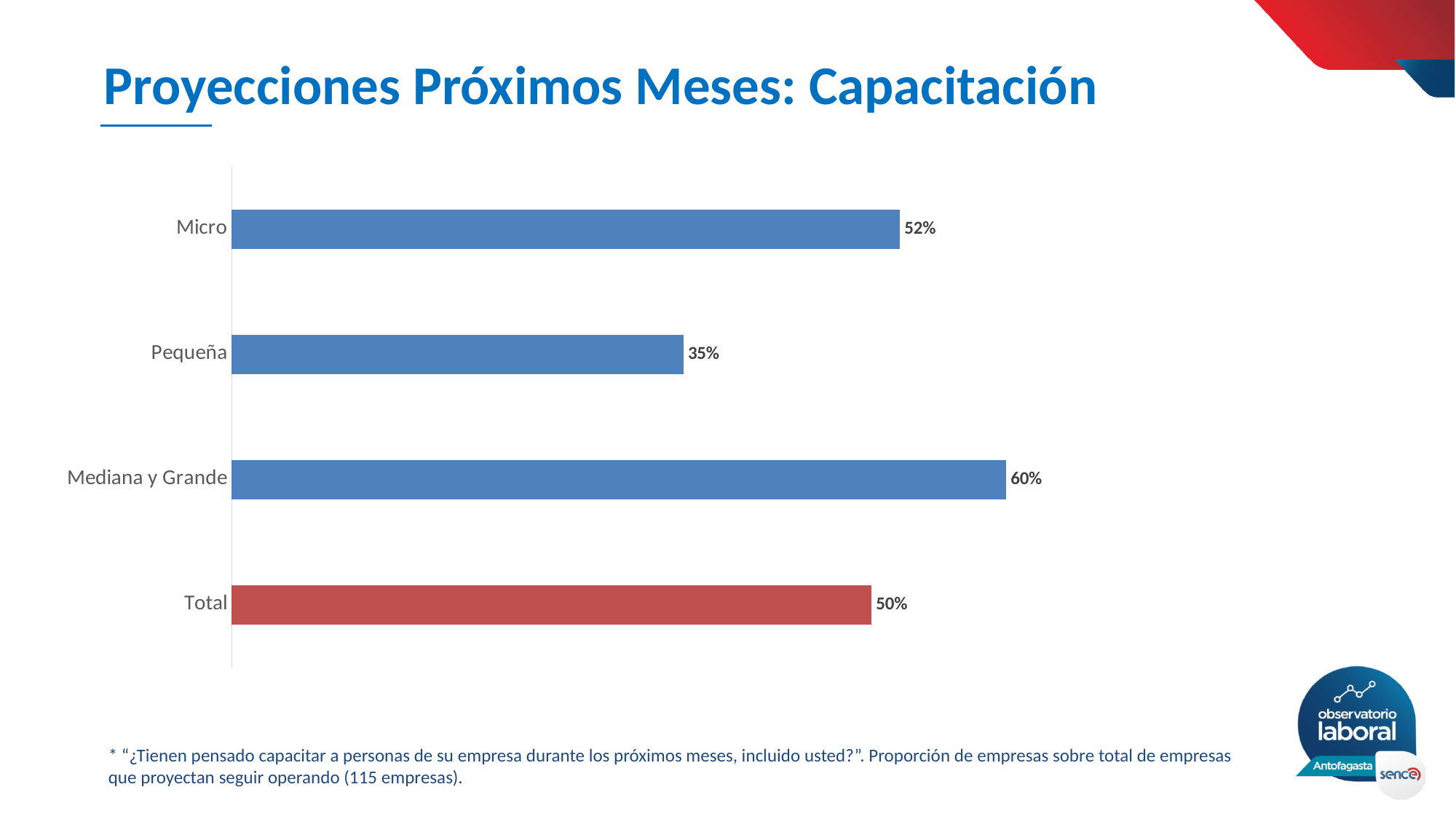
Which category has the lowest value? Pequeña What kind of chart is shown on the slide? Bar chart What is the value for Total? 50% Which is larger, the value for Micro or the value for Pequeña? Micro Which category has the highest value? Mediana y Grande What is the difference between the values for Micro and Total? 2% What is the value for Micro? 52% How many categories are shown in the chart? 4 What is the difference between the values for Mediana y Grande and Pequeña? 25% What is the value for Pequeña? 35% What is the value for Mediana y Grande? 60% Which bar is coloured red rather than blue? Total